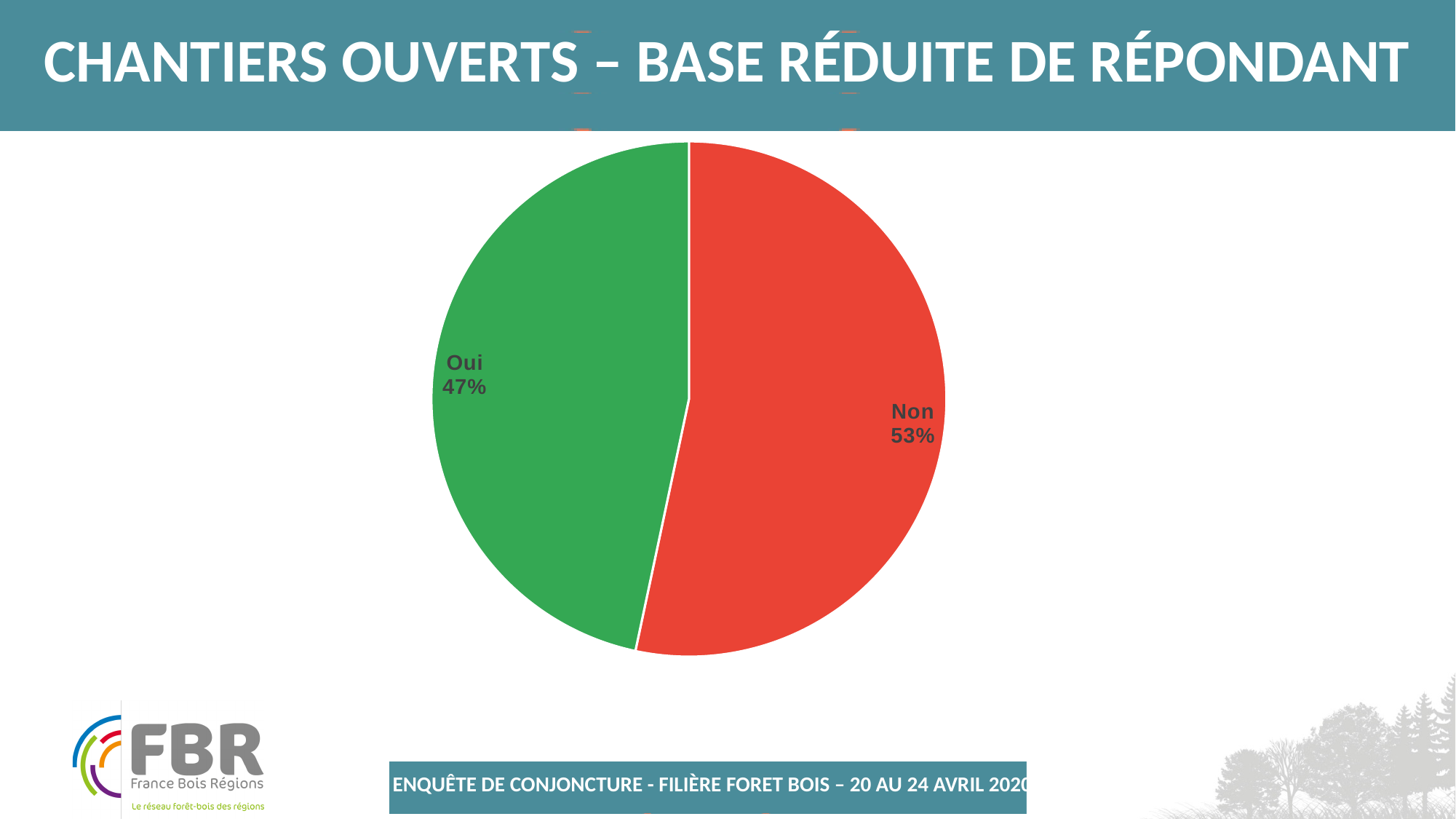
What colour is the "Non" slice? Red What percentage of respondents answered "Oui"? 47% What share of the pie does the "Non" slice represent? 53% What colour is the "Oui" slice? Green Which slice of the pie is the largest? Non How many slices does the pie chart have? 2 What is the difference in percentage points between the "Non" and "Oui" slices? 6 What type of chart is shown on the slide? Pie chart Which is larger, the "Oui" slice or the "Non" slice? Non Which slice of the pie is the smallest? Oui What percentage of respondents answered "Non"? 53%